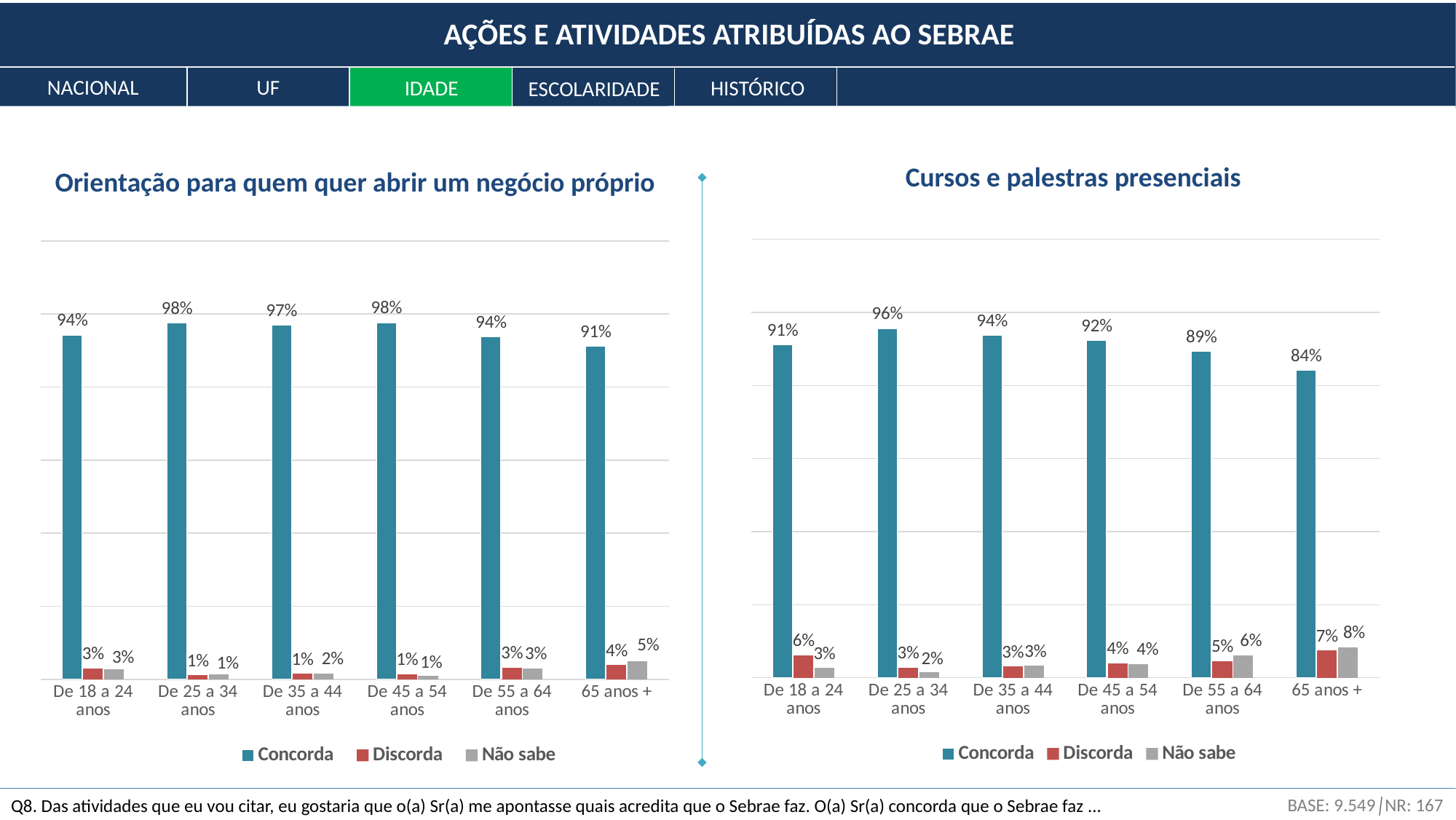
In the chart 'Cursos e palestras presenciais', which age group has the highest Concorda value? De 25 a 34 anos In the chart 'Orientação para quem quer abrir um negócio próprio', what is the difference between the Concorda values for 'De 25 a 34 anos' and '65 anos +'? 7% Which is larger: the Concorda value for 'De 18 a 24 anos' in the left chart or in the right chart? Left chart (94%) What type of chart is 'Cursos e palestras presenciais'? Bar chart How many age groups are shown on the x axis of the chart 'Cursos e palestras presenciais'? 6 In the chart 'Cursos e palestras presenciais', what is the difference between the Concorda values for 'De 25 a 34 anos' and '65 anos +'? 12% In the chart 'Cursos e palestras presenciais', which age group has the lowest Concorda value? 65 anos + In the chart 'Orientação para quem quer abrir um negócio próprio', what is the Concorda value for 'De 35 a 44 anos'? 97% How many series does the legend of the chart 'Orientação para quem quer abrir um negócio próprio' list? 3 In the chart 'Cursos e palestras presenciais', what is the Concorda value for 'De 55 a 64 anos'? 89% In the chart 'Cursos e palestras presenciais', what is the Não sabe value for '65 anos +'? 8% In the chart 'Orientação para quem quer abrir um negócio próprio', which age group has the lowest Concorda value? 65 anos +